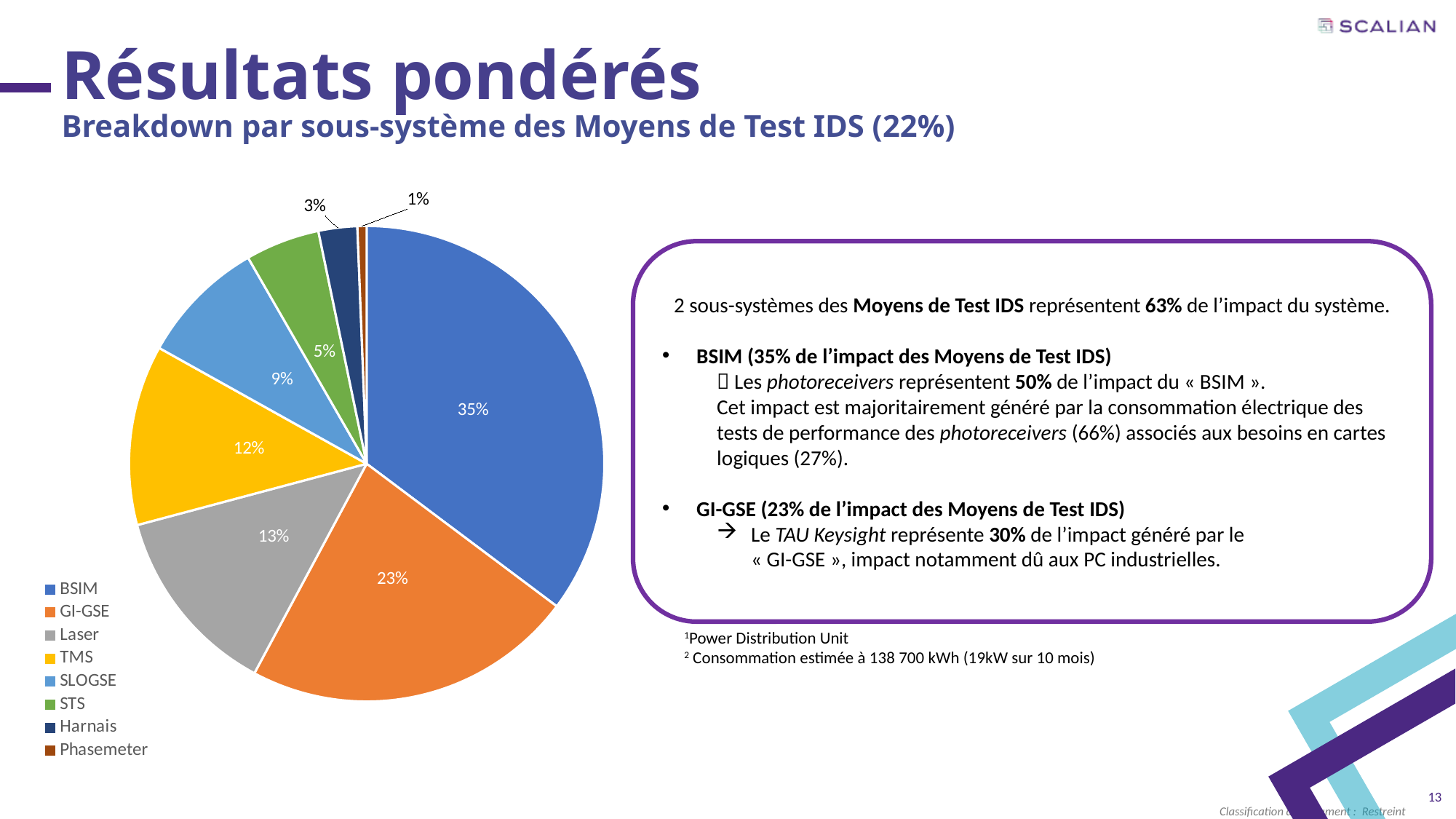
Which is larger, the TMS slice or the STS slice? TMS Which category has the smallest slice of the pie? Phasemeter What share of the pie does GI-GSE represent? 23% What kind of chart is shown on the slide? pie chart What is the difference between the BSIM and GI-GSE shares? 12% Which category has the largest slice of the pie? BSIM What share of the pie does BSIM represent? 35% What is the value shown for SLOGSE? 9% What is the value shown for Phasemeter? 1% What colour is the Harnais slice in the pie chart? dark navy blue What is the value shown for Laser? 13% How many categories does the legend list? 8